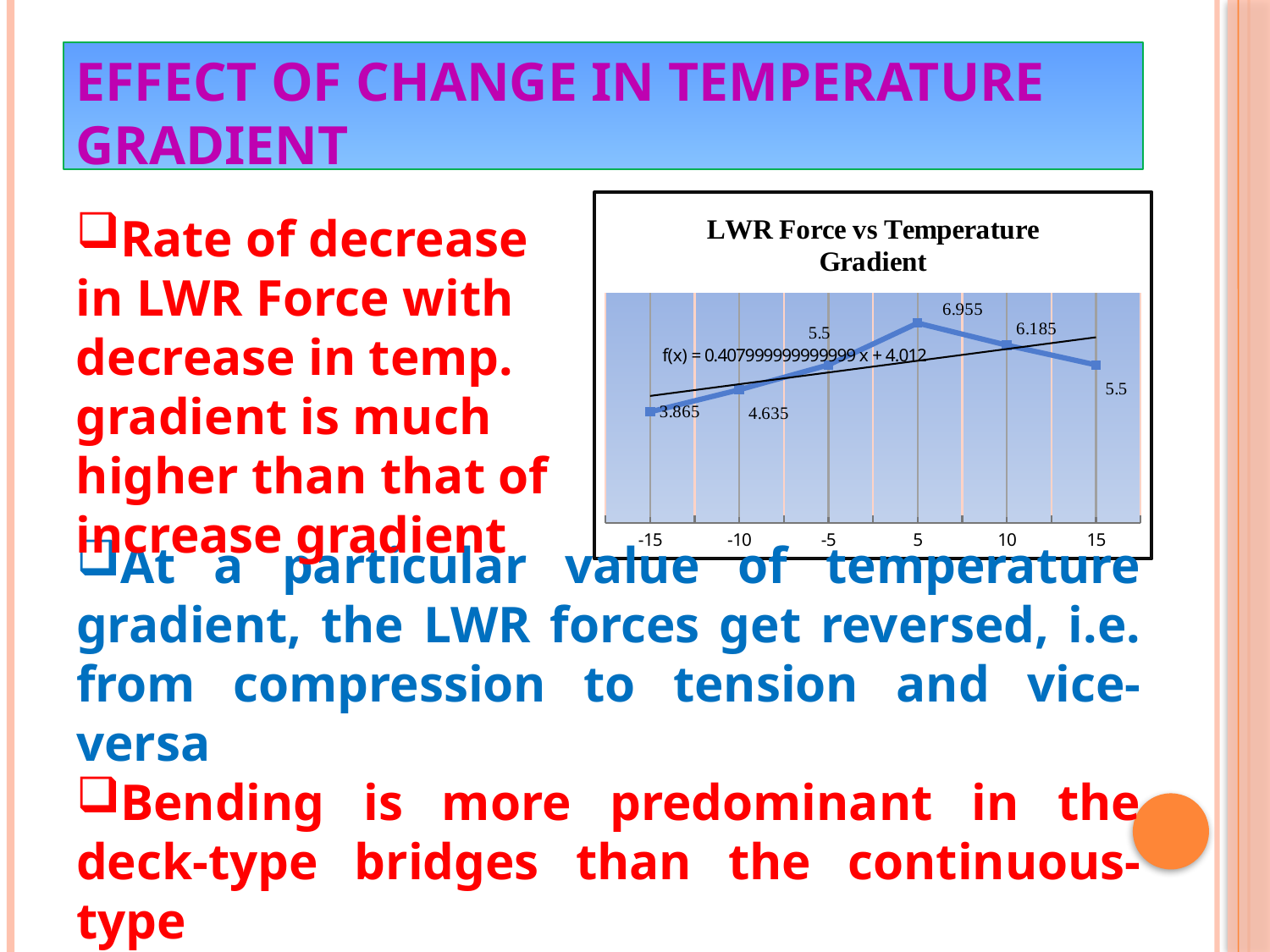
What is the LWR Force value at a temperature gradient of 10? 6.185 At which temperature gradient is the LWR Force lowest? -15 How many temperature gradient points are plotted on the chart? 6 What is the equation of the trendline shown on the chart? f(x) = 0.407999999999999 x + 4.012 What kind of chart is shown on the slide? line chart What is the LWR Force value at a temperature gradient of -15? 3.865 What is the LWR Force value at a temperature gradient of 5? 6.955 Which has a larger LWR Force value: a temperature gradient of 10 or of -10? 10 What is the title of the chart? LWR Force vs Temperature Gradient What is the LWR Force value at a temperature gradient of -10? 4.635 At which temperature gradient is the LWR Force highest? 5 What is the difference between the LWR Force at a gradient of 5 and at a gradient of -15? 3.09